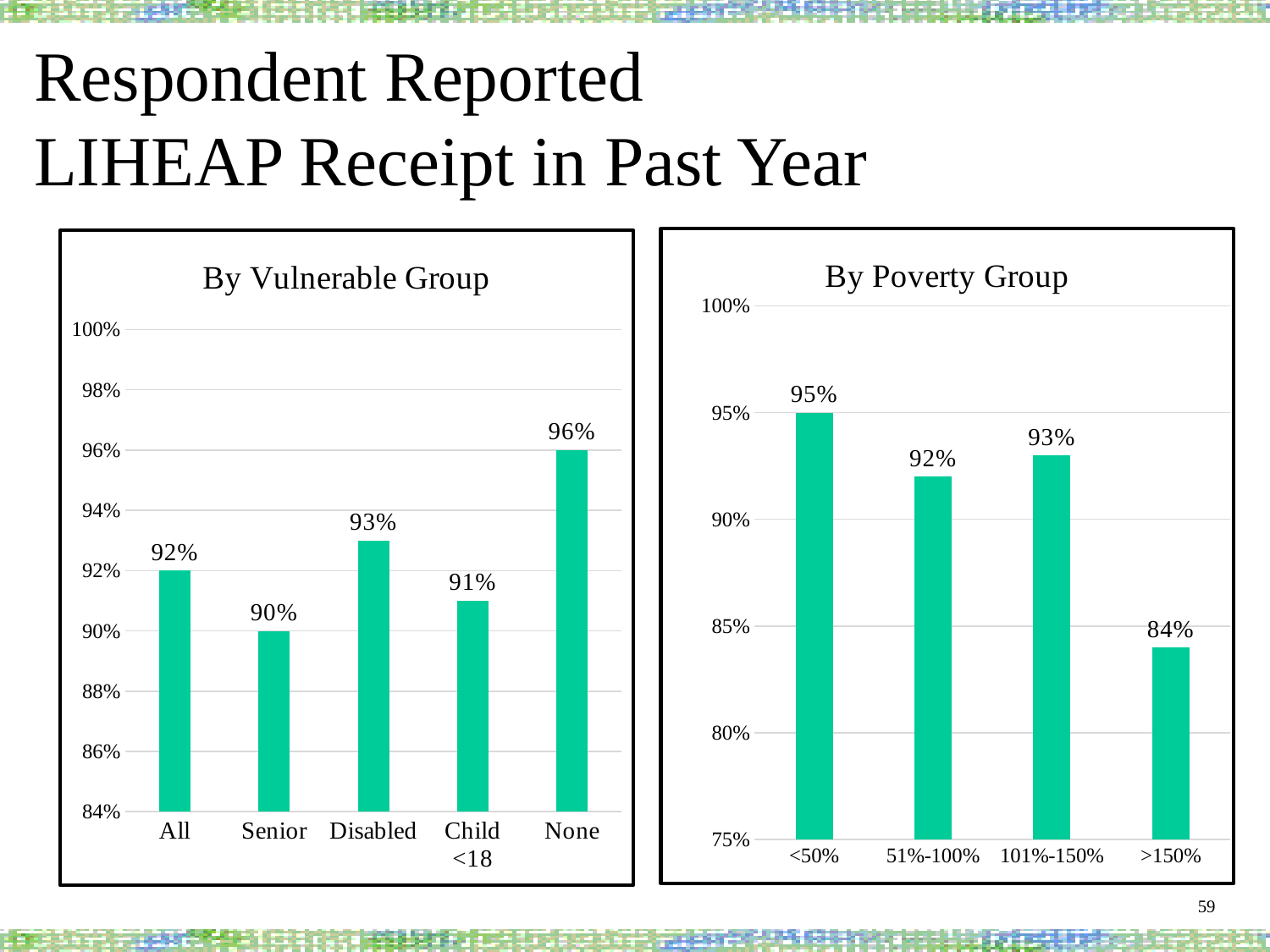
In the 'By Poverty Group' chart, how many categories are shown? 4 In the 'By Vulnerable Group' chart, which category has the lowest value? Senior In the 'By Vulnerable Group' chart, which category has the highest value? None In the 'By Vulnerable Group' chart, how many categories are shown? 5 In the 'By Poverty Group' chart, what is the difference between the values for <50% and >150%? 11% In the 'By Poverty Group' chart, what is the value for 51%-100%? 92% In the 'By Poverty Group' chart, which category has the highest value? <50% In the 'By Poverty Group' chart, is the value for 101%-150% larger or smaller than the value for 51%-100%? larger What kind of chart is the 'By Vulnerable Group' chart? bar chart In the 'By Vulnerable Group' chart, what is the value for Senior? 90% In the 'By Poverty Group' chart, which category has the lowest value? >150% In the 'By Vulnerable Group' chart, what is the difference between the values for None and Child <18? 5%